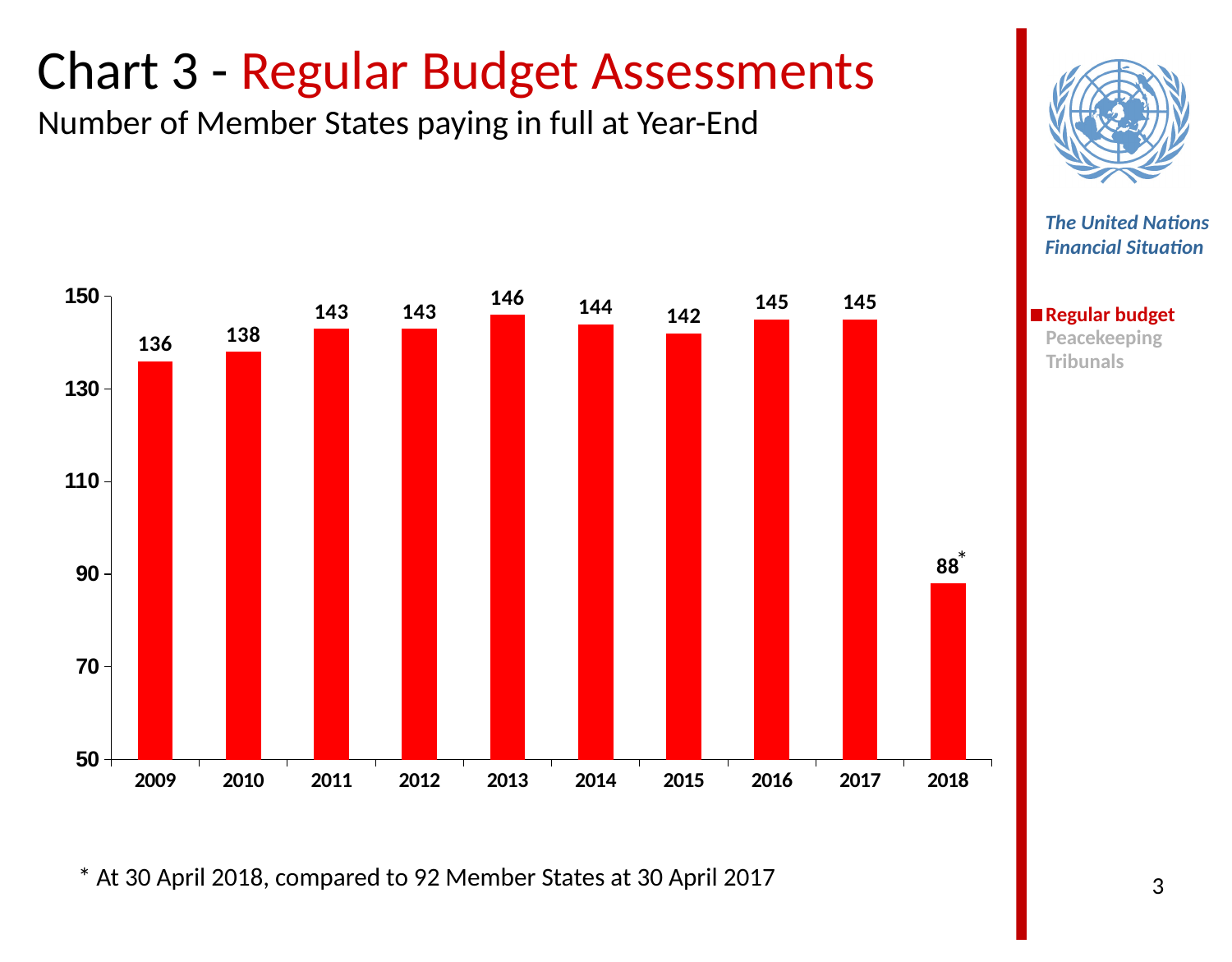
How many Member States paid in full at year-end in 2009? 136 What is the value shown for 2018? 88 What is the subtitle of the chart? Number of Member States paying in full at Year-End What is the difference between the values for 2017 and 2018? 57 What is the difference between the values for 2013 and 2009? 10 How many years are shown on the x axis? 10 Is the value for 2018 greater or less than 90? less Which year has the highest number of Member States paying in full? 2013 What kind of chart is this? bar chart Which is larger, the value for 2010 or the value for 2015? 2015 What is the value shown for 2013? 146 Which year has the lowest value on the chart? 2018